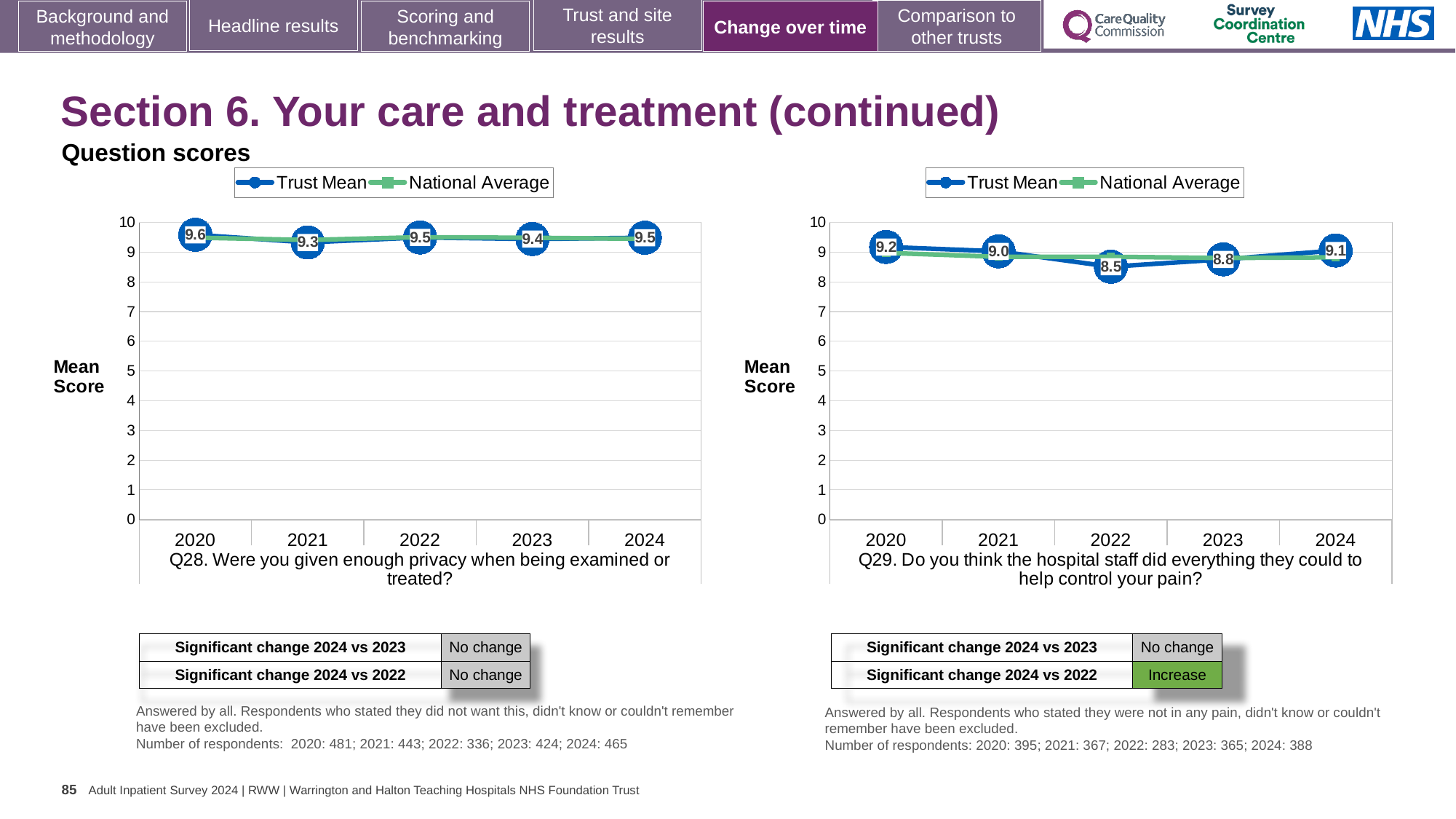
In the Q28 chart (left), what is the Trust Mean score for 2020? 9.6 How many series does the legend of the Q29 chart (right) list? 2 In the Q29 chart (right), is the Trust Mean value for 2022 greater or less than 9? less In the Q29 chart (right), what is the difference between the Trust Mean scores for 2020 and 2022? 0.7 In the Q28 chart (left), is the Trust Mean score for 2021 larger or smaller than the score for 2022? smaller What kind of chart is used for Q28 (left)? Line chart How many years are shown on the x axis of the Q28 chart (left)? 5 In the Q29 chart (right), which year has the lowest Trust Mean score? 2022 In the Q28 chart (left), what is the Trust Mean score for 2021? 9.3 In the Q28 chart (left), which year has the highest Trust Mean score? 2020 In the Q29 chart (right), what is the Trust Mean score for 2022? 8.5 In the Q29 chart (right), what is the Trust Mean score for 2024? 9.1